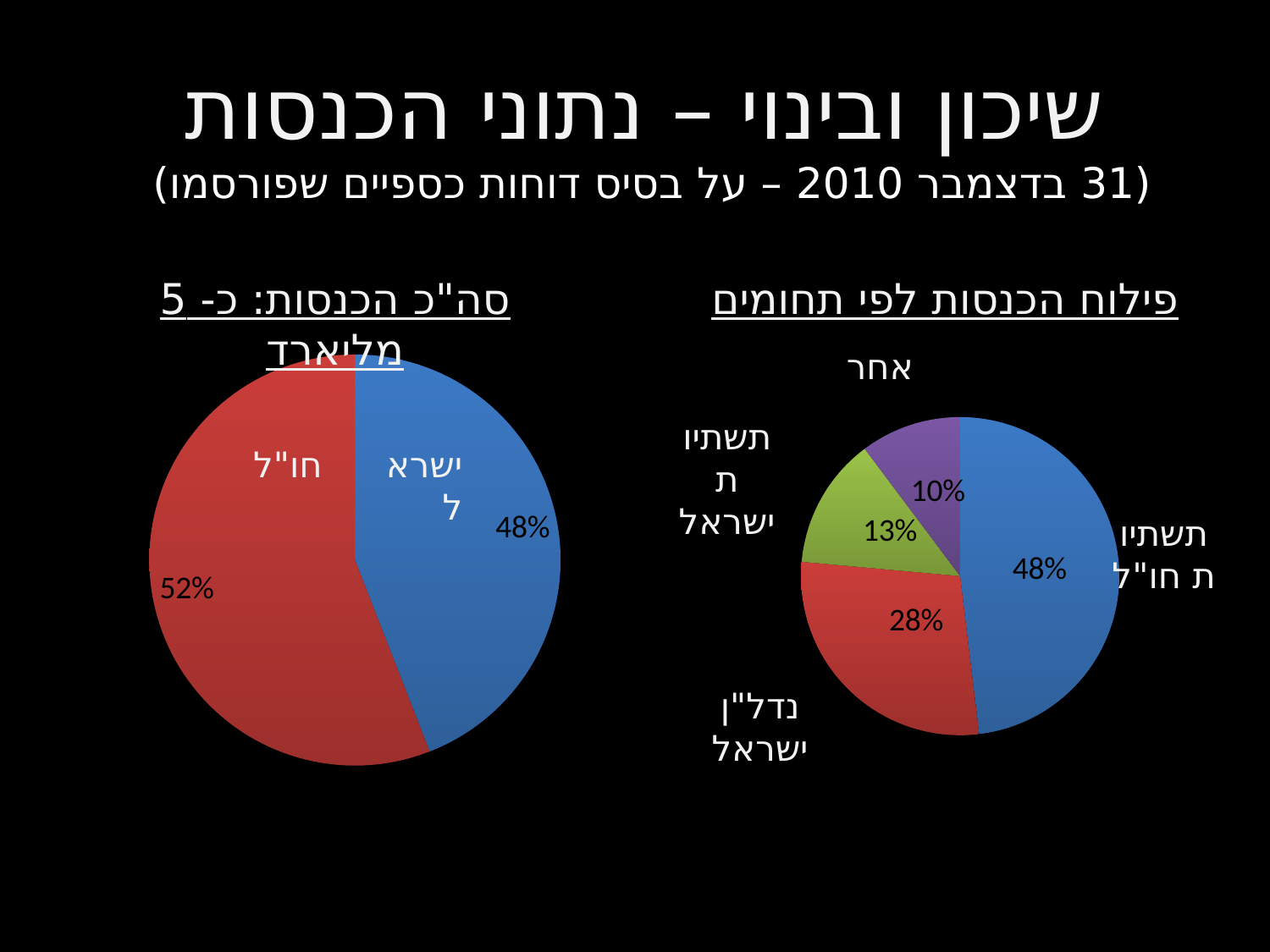
In the right pie chart (פילוח הכנסות לפי תחומים), what share is labelled for תשתיות חו"ל? 48% What type of chart is used for פילוח הכנסות לפי תחומים on the right of the slide? Pie chart In the right pie chart (פילוח הכנסות לפי תחומים), what share is labelled for נדל"ן ישראל? 28% In the left pie chart (סה"כ הכנסות: כ- 5 מליארד), what share is labelled for חו"ל? 52% In the right pie chart (פילוח הכנסות לפי תחומים), which category has the largest share? תשתיות חו"ל In the right pie chart (פילוח הכנסות לפי תחומים), what is the difference in percentage points between תשתיות חו"ל and נדל"ן ישראל? 20 percentage points How many slices does the left pie chart (סה"כ הכנסות: כ- 5 מליארד) have? 2 In the right pie chart (פילוח הכנסות לפי תחומים), which category has the smallest share? אחר In the left pie chart (סה"כ הכנסות: כ- 5 מליארד), which slice is larger, ישראל or חו"ל? חו"ל